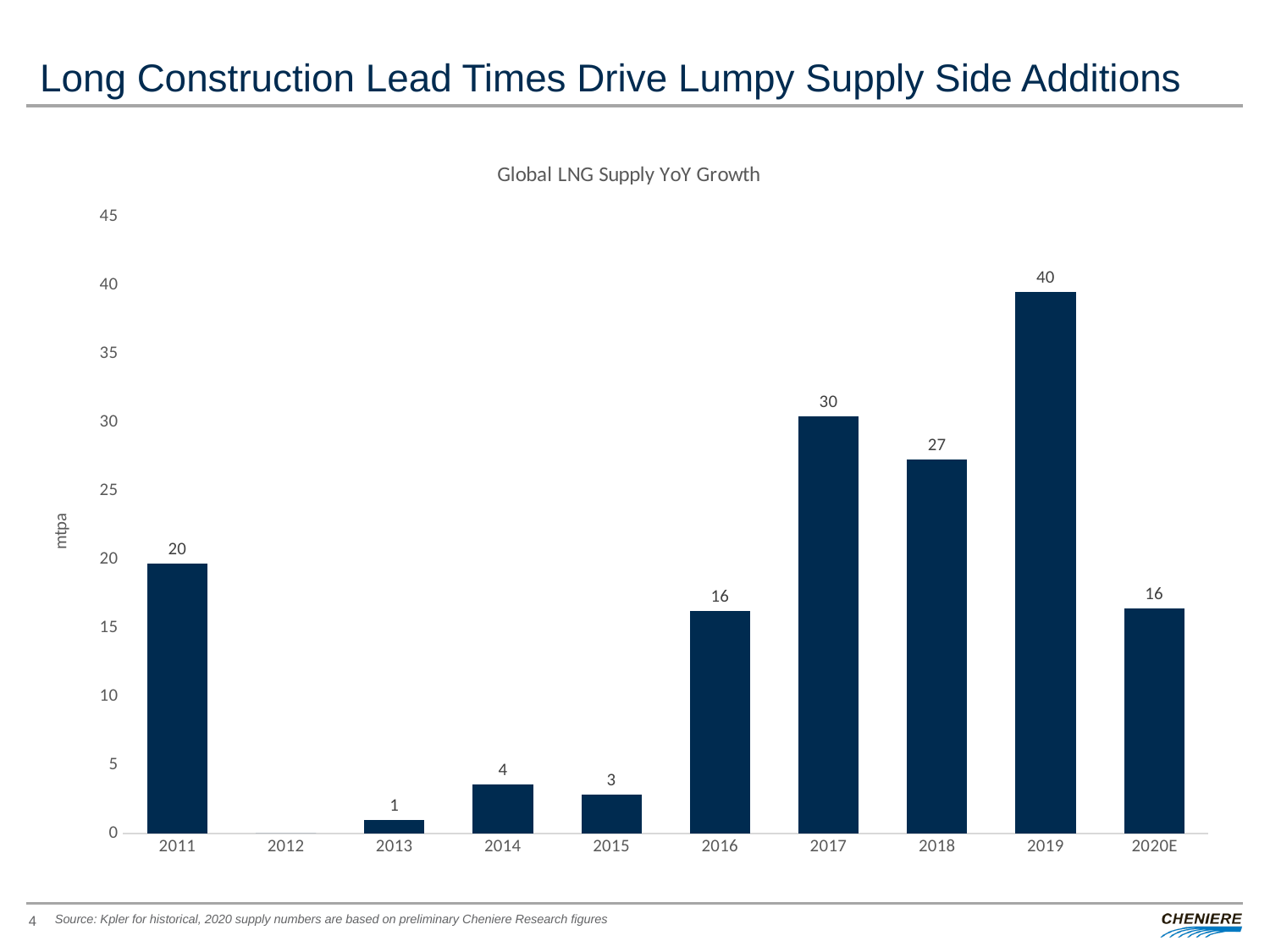
Which is larger, the value for 2014 or the value for 2015? 2014 What is the value for 2019? 40 What kind of chart is this? Bar chart What is the difference between the values for 2019 and 2020E? 24 How many years are shown on the x axis? 10 Which year has the highest value? 2019 What is the difference between the values for 2017 and 2018? 3 What is the value for 2020E? 16 Do the values rise or fall from 2016 to 2017? Rise Is the value for 2018 greater or less than 25? greater What is the title of the chart? Global LNG Supply YoY Growth What is the value for 2011? 20